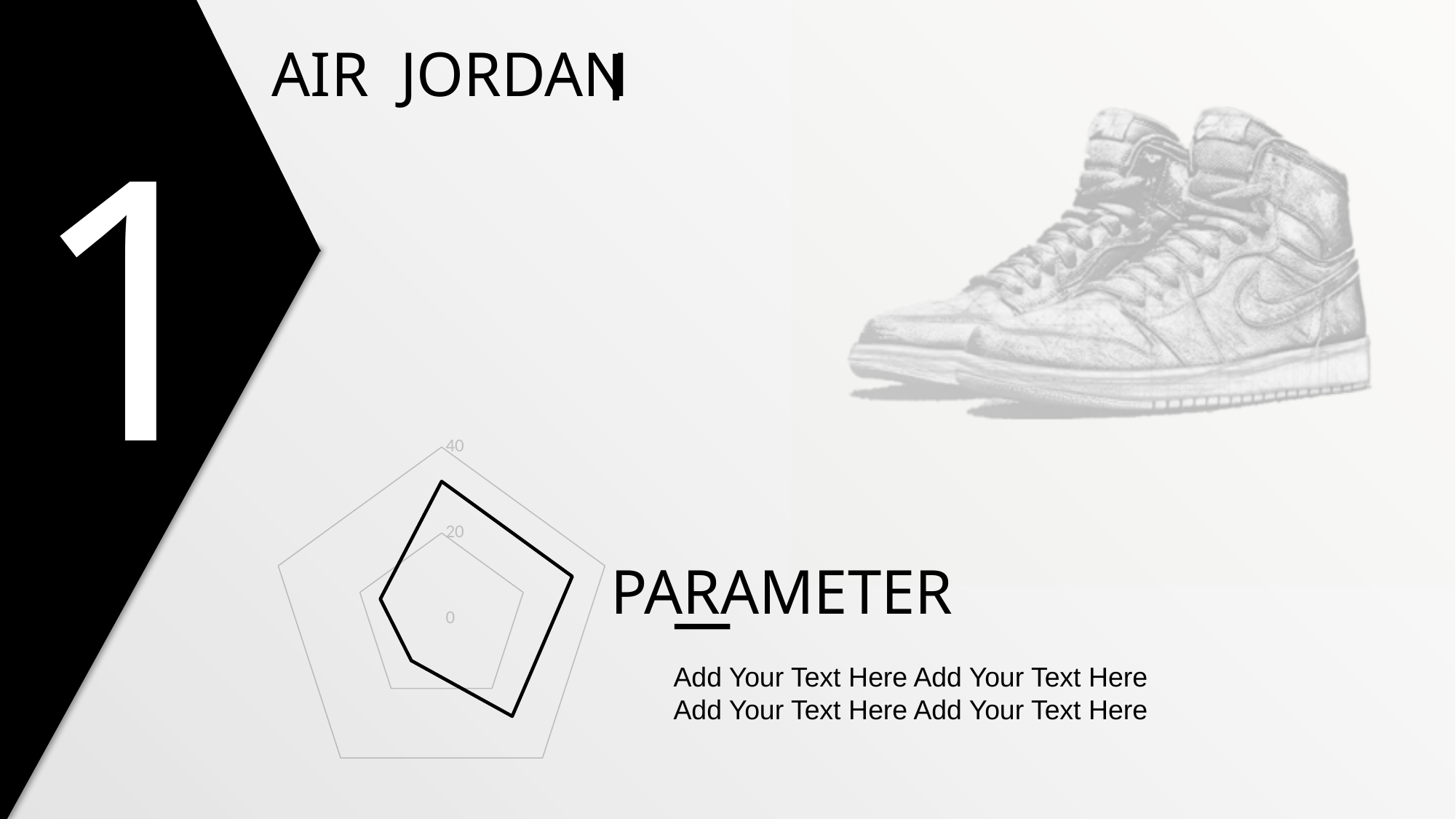
How many axes (data points) does the radar chart have? 5 Is the value on the left axis of the radar chart greater or less than 40? less What is the lowest value shown on the radar chart's axis scale? 0 How many data series are plotted on the radar chart? 1 What kind of chart is shown on the slide? radar chart What is the highest value shown on the radar chart's axis scale? 40 Is the value on the top axis of the radar chart greater or less than 20? greater